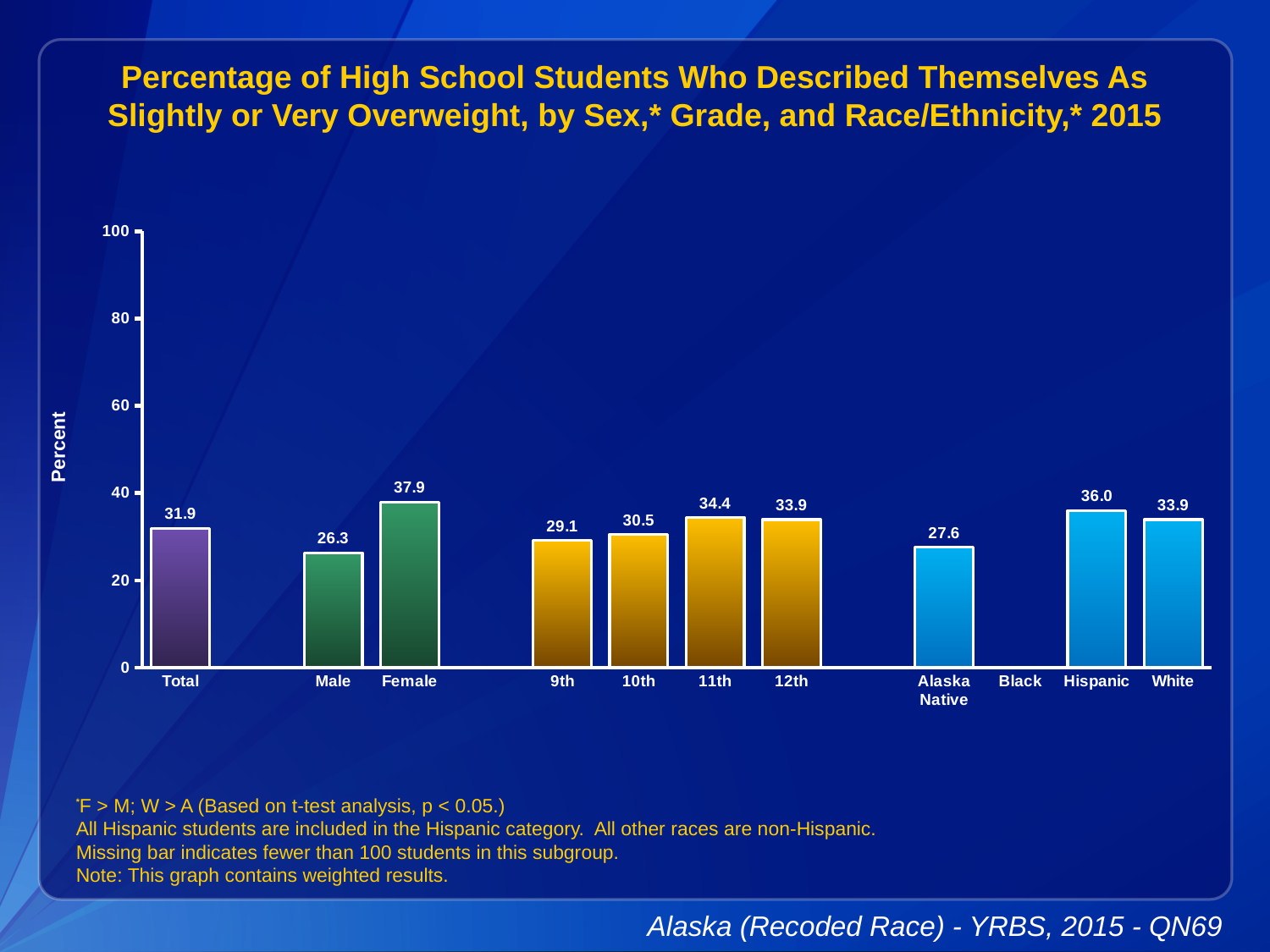
What is the value for Female? 37.9 Do the values rise or fall from 9th grade to 11th grade? rise What is the value for Total? 31.9 How many bars are plotted on the chart? 10 Which is larger, the value for 11th grade or the value for 9th grade? 11th Which race/ethnicity category has no bar shown? Black Which category has the lowest value among the bars shown? Male Which category has the highest value? Female Is the value for Hispanic greater or less than 20? greater What is the value for Alaska Native? 27.6 What kind of chart is shown? bar chart What is the difference between the Female and Male values? 11.6